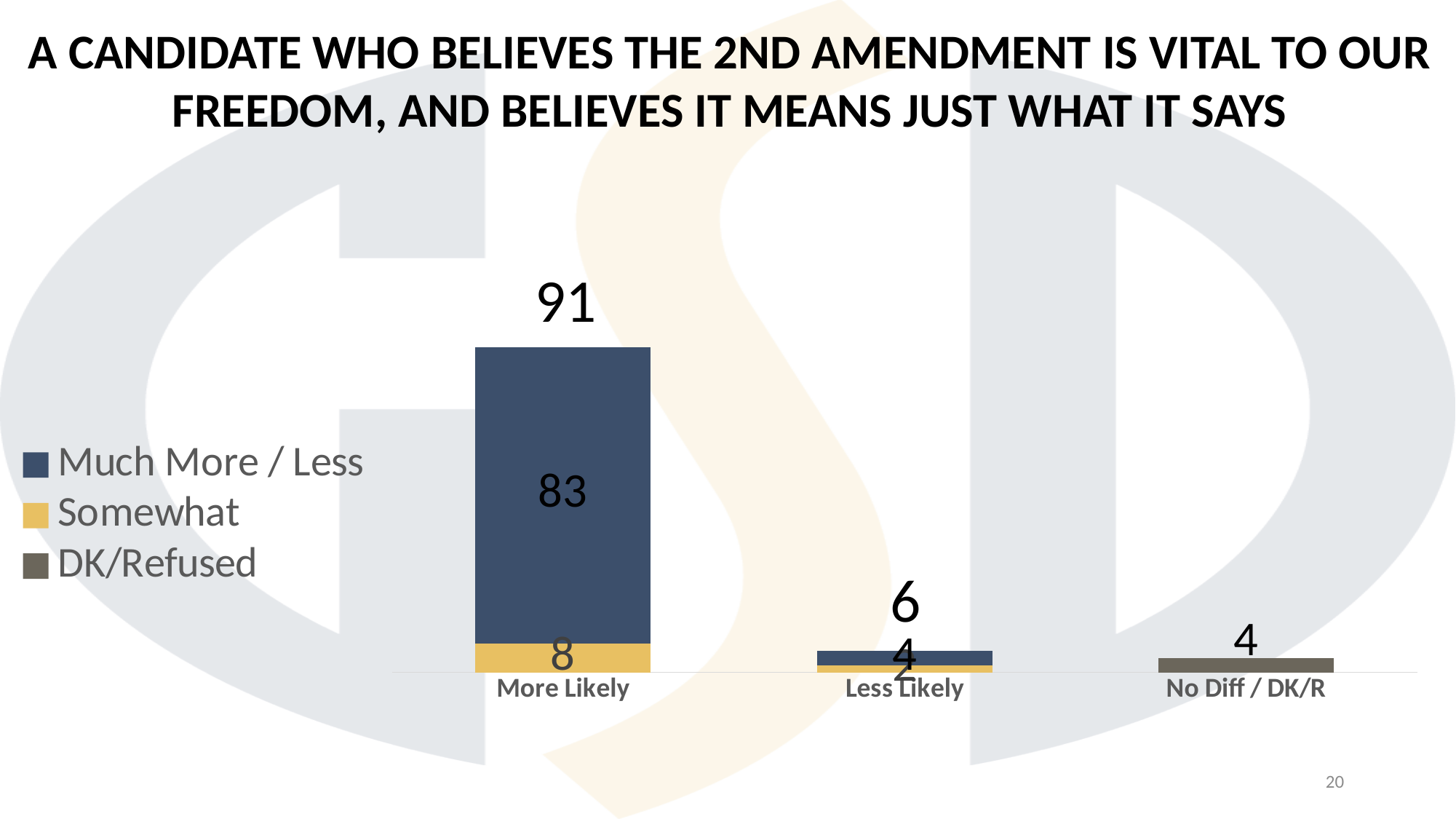
Which is larger: the Much More / Less value for More Likely or for Less Likely? More Likely What is the Much More / Less value for Less Likely? 4 How many categories are shown on the x axis? 3 What is the total shown above the More Likely bar? 91 What is the total shown above the Less Likely bar? 6 Which category has the highest total? More Likely What is the Somewhat value for More Likely? 8 How many series does the legend list? 3 What is the difference between the More Likely total and the Less Likely total? 85 What is the value for No Diff / DK/R? 4 What is the Much More / Less value for More Likely? 83 What kind of chart is shown on the slide? Stacked bar chart